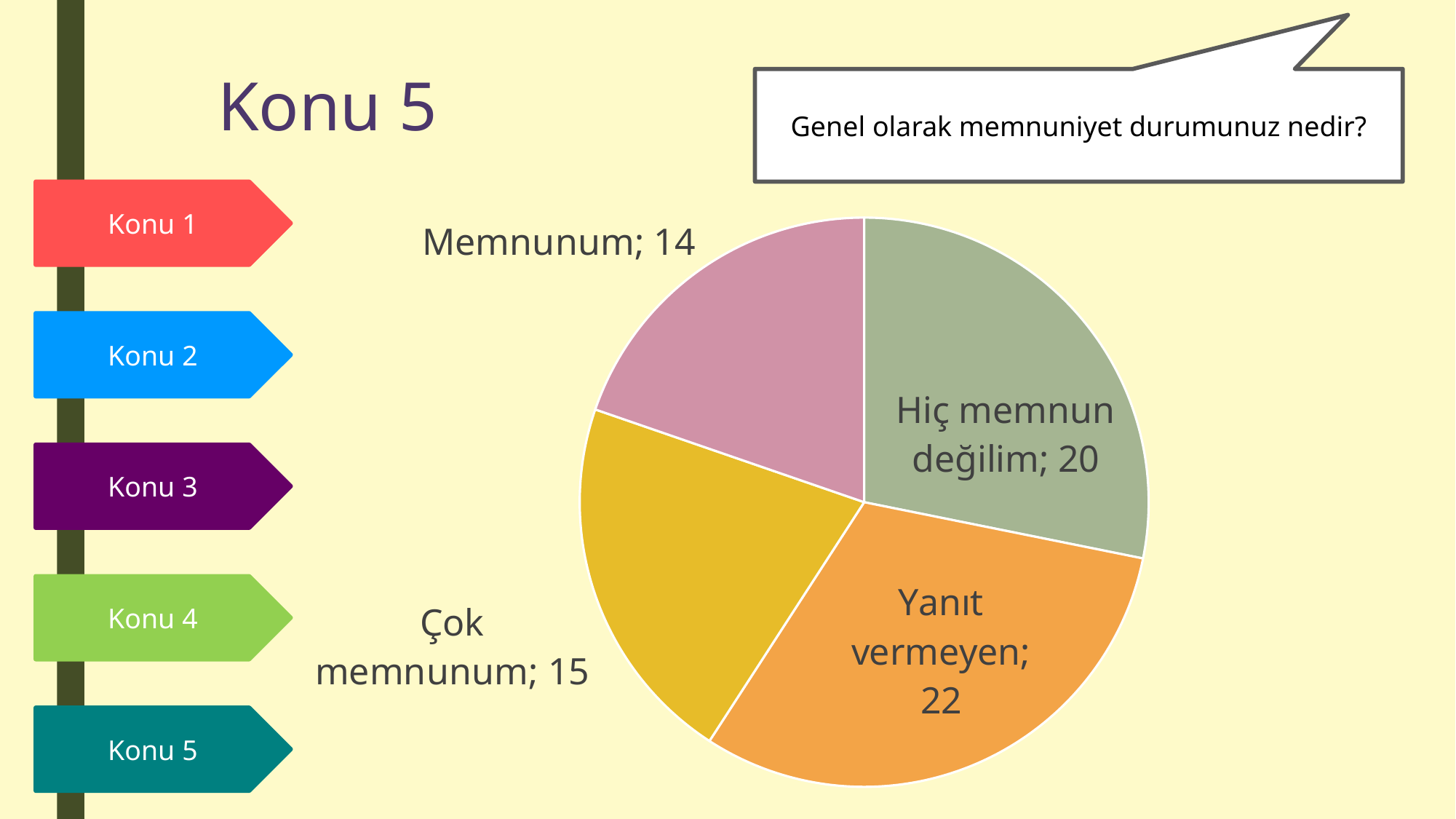
What kind of chart is shown on the slide? pie chart What is the sum of all the values shown in the pie chart? 71 Which is larger, the value for "Hiç memnun değilim" or the value for "Yanıt vermeyen"? Yanıt vermeyen What is the value for "Memnunum" in the pie chart? 14 How many slices does the pie chart have? 4 What is the value for "Yanıt vermeyen" in the pie chart? 22 Which category has the largest slice in the pie chart? Yanıt vermeyen Which category has the smallest slice in the pie chart? Memnunum What is the value for "Çok memnunum" in the pie chart? 15 What is the value for "Hiç memnun değilim" in the pie chart? 20 What question is written in the callout box above the pie chart? Genel olarak memnuniyet durumunuz nedir? What is the difference between the values for "Yanıt vermeyen" and "Memnunum"? 8